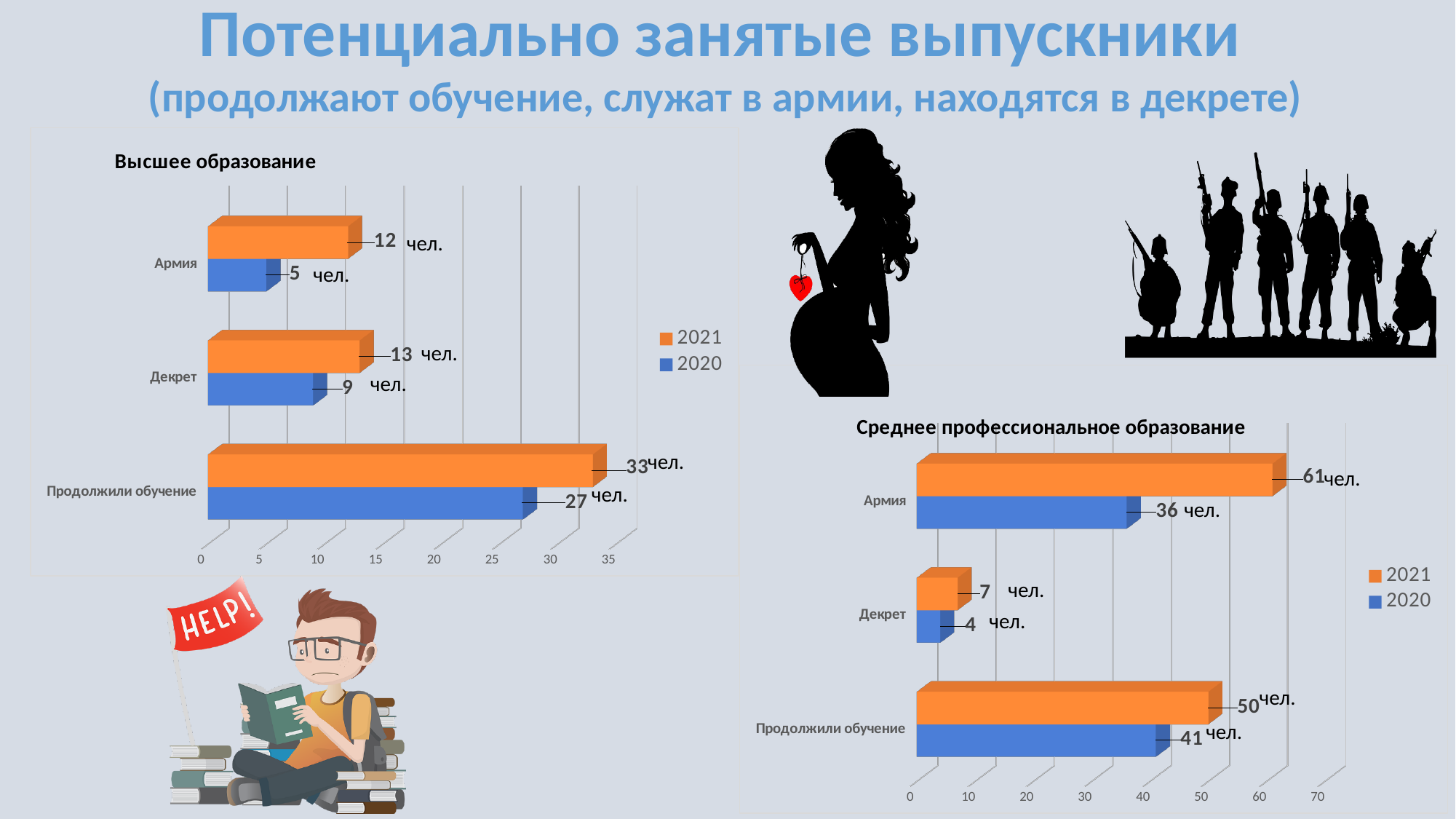
In the 'Среднее профессиональное образование' chart, which category has the lowest 2020 value? Декрет In the 'Среднее профессиональное образование' chart, what is the difference between the 2021 and 2020 values for Армия? 25 чел. In the 'Высшее образование' chart, which category has the highest 2021 value? Продолжили обучение In the 'Высшее образование' chart, what is the 2021 value for Продолжили обучение? 33 чел. In the 'Высшее образование' chart, what is the difference between the 2021 and 2020 values for Декрет? 4 чел. In the 'Высшее образование' chart, what is the 2020 value for Армия? 5 чел. In the 'Среднее профессиональное образование' chart, what is the 2021 value for Армия? 61 чел. What type of chart is the 'Высшее образование' chart? Bar chart How many categories are shown in the 'Высшее образование' chart? 3 In the 'Среднее профессиональное образование' chart, what is the 2020 value for Декрет? 4 чел. In the 'Среднее профессиональное образование' chart, which is larger: the 2021 value for Армия or the 2021 value for Продолжили обучение? Армия How many series does the legend of the 'Среднее профессиональное образование' chart list? 2